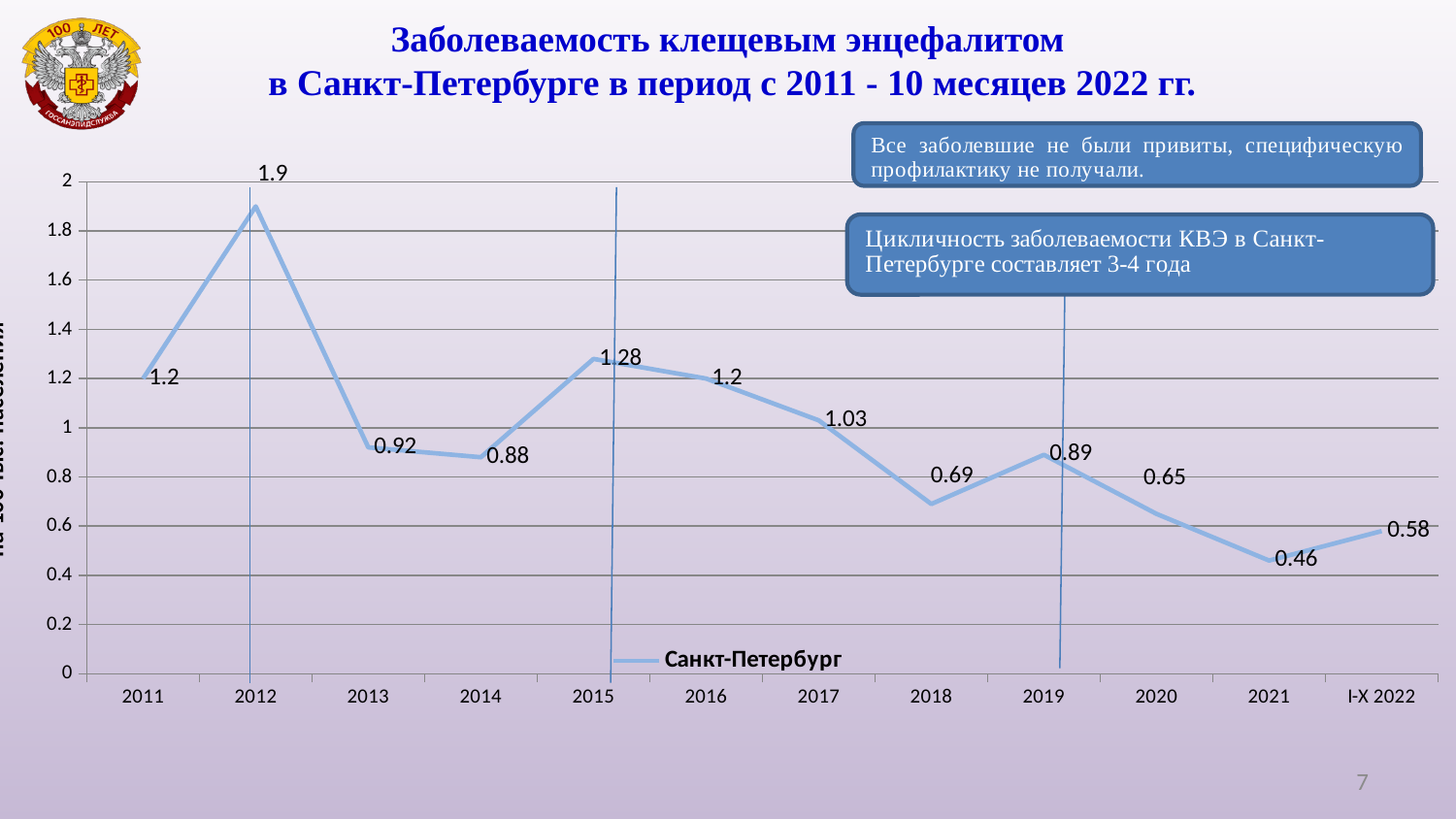
What is the value for 2012? 1.9 Which year has the lowest value? 2021 What is the difference between the values for 2015 and 2016? 0.08 What is the value for 2018? 0.69 What is the value for I-X 2022? 0.58 What kind of chart is shown on the slide? line chart Which is larger, the value for 2019 or the value for 2020? 2019 How many data points are plotted on the chart? 12 Which year has the highest value? 2012 Is the value for 2017 greater or less than 1? greater What series name is shown in the chart legend? Санкт-Петербург What is the difference between the values for 2012 and 2013? 0.98